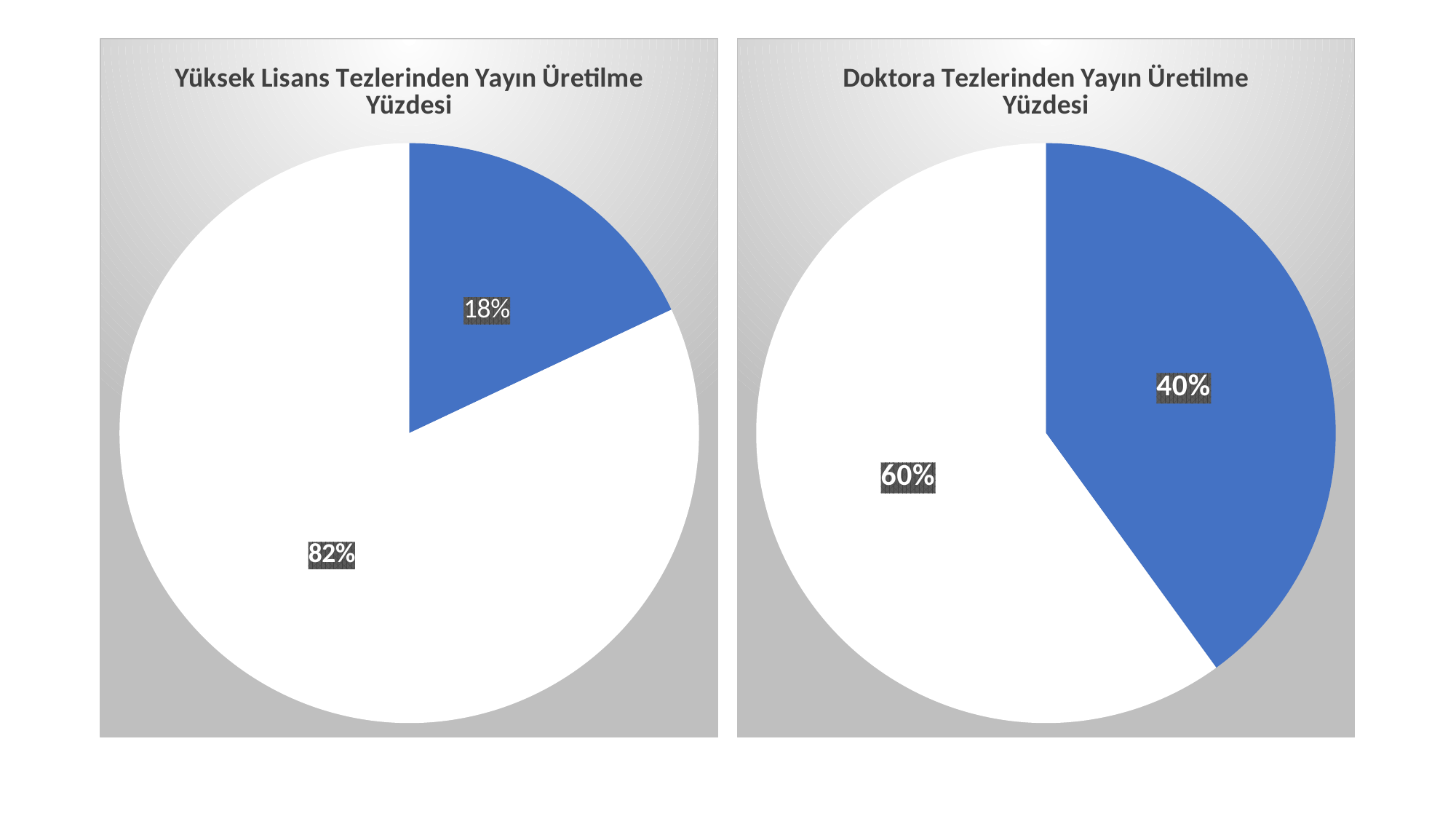
How many slices does the left chart (Yüksek Lisans Tezlerinden Yayın Üretilme Yüzdesi) have? 2 What is the difference between the blue slice in the right chart (Doktora Tezlerinden Yayın Üretilme Yüzdesi) and the blue slice in the left chart (Yüksek Lisans Tezlerinden Yayın Üretilme Yüzdesi)? 22% In the left chart (Yüksek Lisans Tezlerinden Yayın Üretilme Yüzdesi), what percentage is shown on the blue slice? 18% In the right chart (Doktora Tezlerinden Yayın Üretilme Yüzdesi), which slice is the smallest, the blue one or the white one? the blue one In the right chart (Doktora Tezlerinden Yayın Üretilme Yüzdesi), what percentage is shown on the blue slice? 40% In the left chart (Yüksek Lisans Tezlerinden Yayın Üretilme Yüzdesi), which slice is the largest, the blue one or the white one? the white one In the right chart (Doktora Tezlerinden Yayın Üretilme Yüzdesi), what percentage is shown on the white slice? 60% How many slices does the right chart (Doktora Tezlerinden Yayın Üretilme Yüzdesi) have? 2 In the left chart (Yüksek Lisans Tezlerinden Yayın Üretilme Yüzdesi), what percentage is shown on the white slice? 82% What kind of chart is the left chart titled "Yüksek Lisans Tezlerinden Yayın Üretilme Yüzdesi"? pie chart What kind of chart is the right chart titled "Doktora Tezlerinden Yayın Üretilme Yüzdesi"? pie chart Which chart has the larger blue slice, the left chart (Yüksek Lisans Tezlerinden Yayın Üretilme Yüzdesi) or the right chart (Doktora Tezlerinden Yayın Üretilme Yüzdesi)? the right chart (Doktora Tezlerinden Yayın Üretilme Yüzdesi)